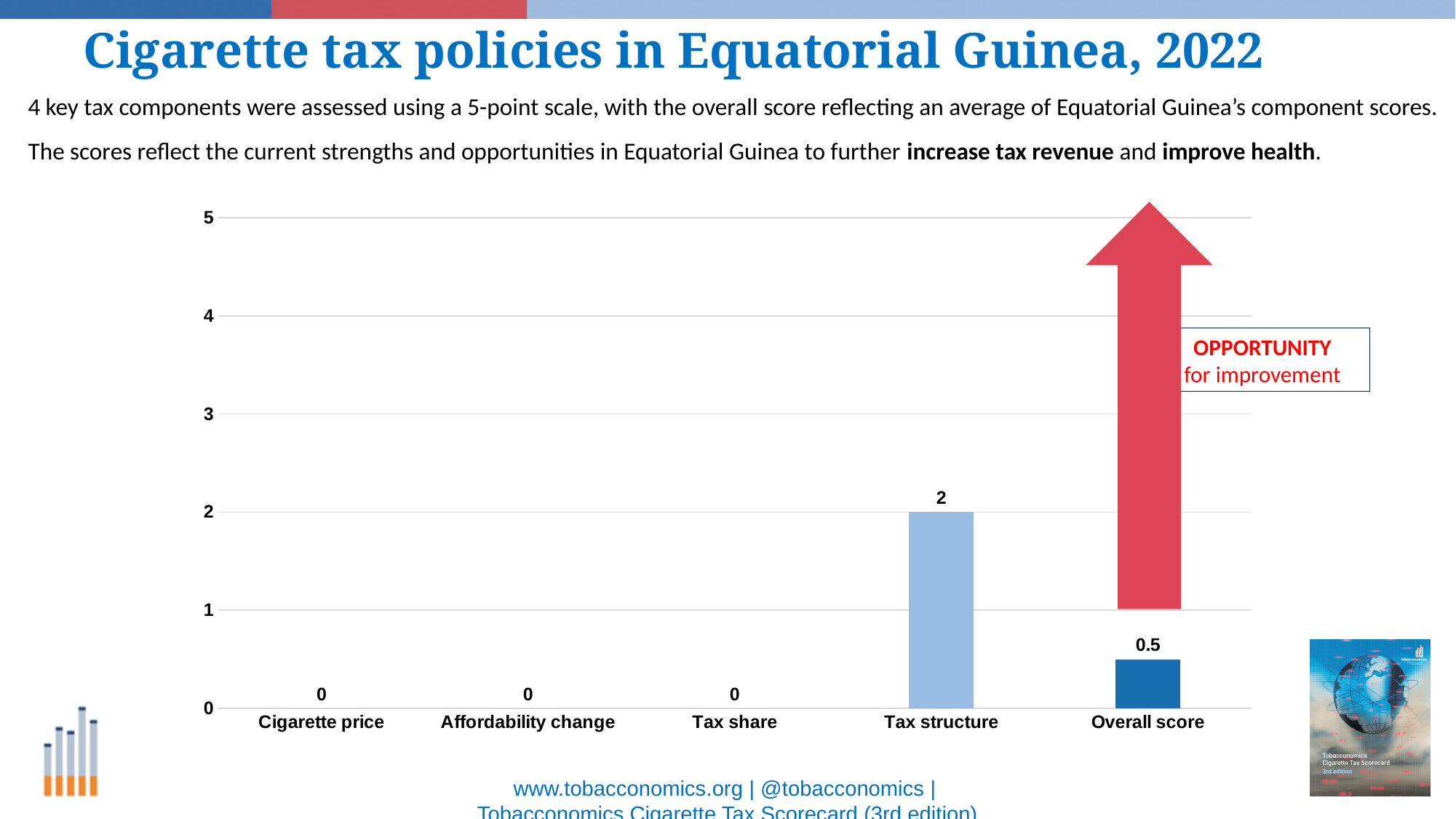
What is the maximum value shown on the y axis? 5 What is the value for Tax structure? 2 How many categories are shown on the x axis? 5 Which category has the highest value? Tax structure How many categories have a value of 0? 3 Which is larger, the value for Tax structure or the value for Overall score? Tax structure What is the value for Cigarette price? 0 What kind of chart is shown on the slide? bar chart What is the value for Overall score? 0.5 Is the value for Overall score greater or less than 1? less What is the difference between the values for Tax structure and Overall score? 1.5 What is the value for Tax share? 0